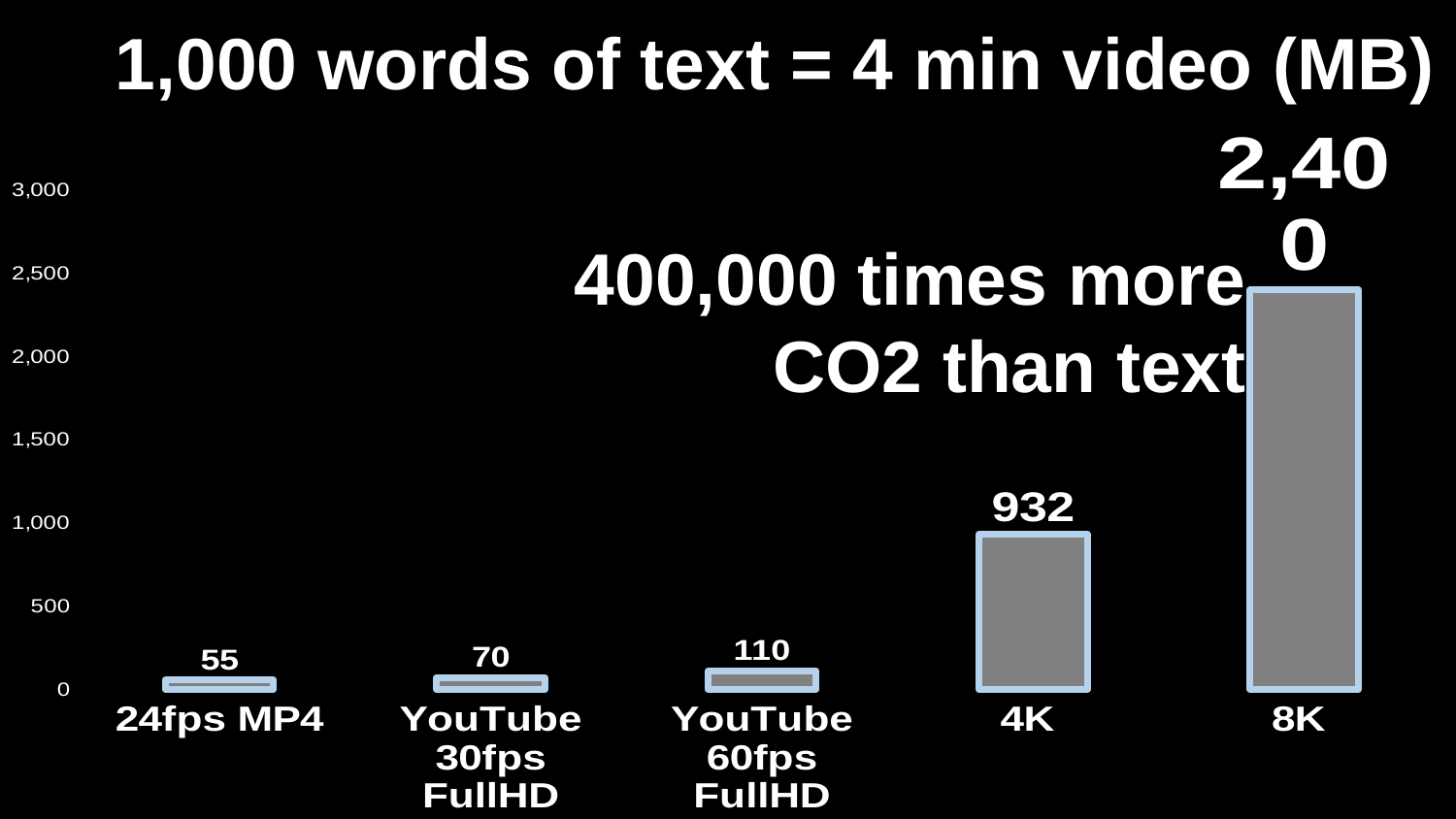
Which is larger, the value for 4K or the value for YouTube 30fps FullHD? 4K What is the value for YouTube 60fps FullHD? 110 What is the title of the chart? 1,000 words of text = 4 min video (MB) Which category has the lowest value? 24fps MP4 What is the difference between the values for YouTube 60fps FullHD and YouTube 30fps FullHD? 40 How many categories are shown on the x axis? 5 Which category has the highest value? 8K What is the value for 8K? 2,400 What is the difference between the values for 8K and 4K? 1,468 What kind of chart is shown on the slide? Bar chart What is the value for 24fps MP4? 55 What is the value for 4K? 932